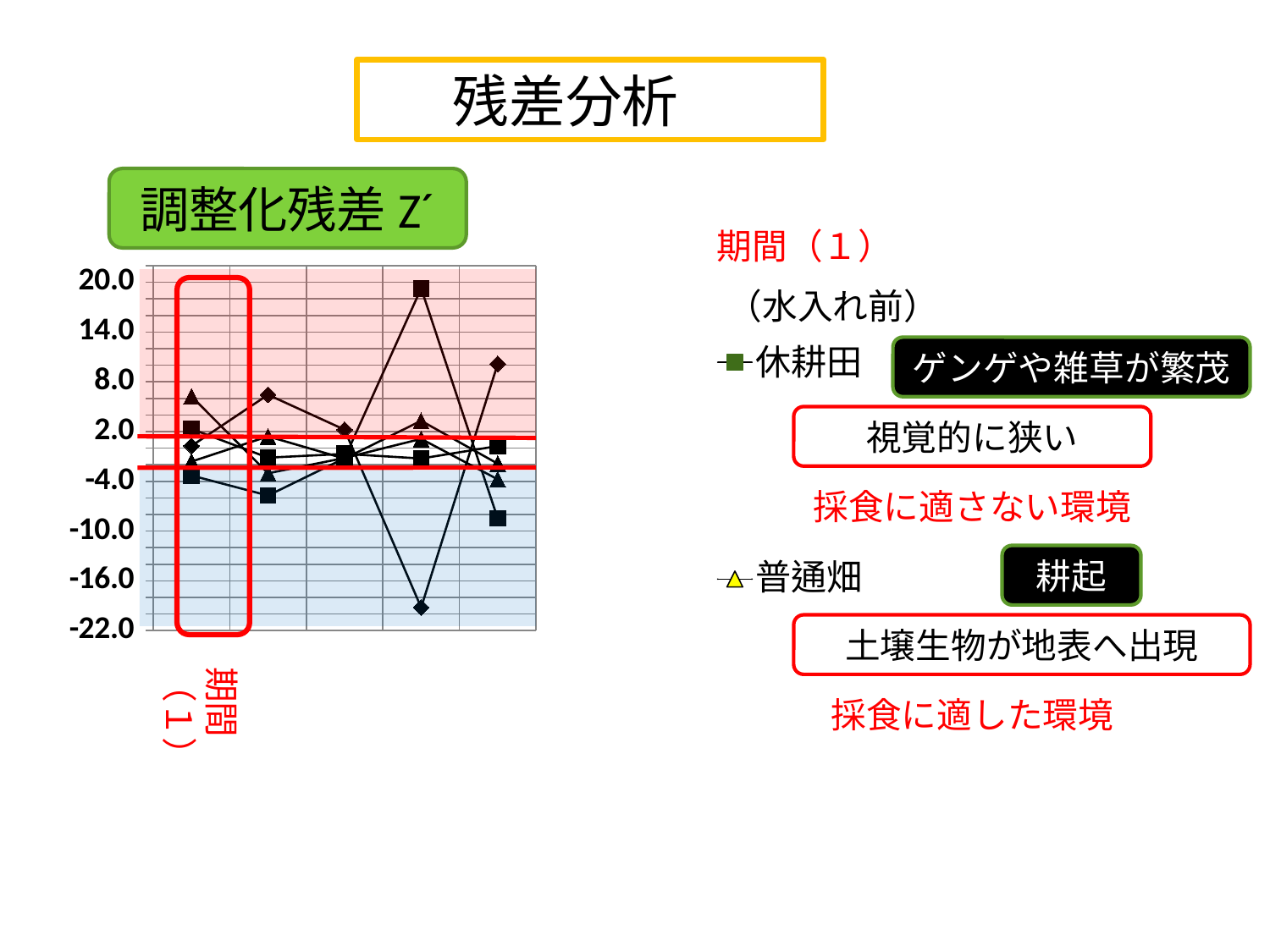
Is the highest plotted point in the chart (the square marker at the fourth x position) greater or less than 14.0? greater What kind of chart is shown on the slide? line chart Is the diamond marker at the last x position greater or less than 8.0? greater How many x positions (time periods) are plotted in the chart? 5 What is the lowest value shown on the y axis of the chart? -22.0 What is the highest value shown on the y axis of the chart? 20.0 Is the lowest plotted point in the chart (the diamond marker at the fourth x position) greater or less than -16.0? less